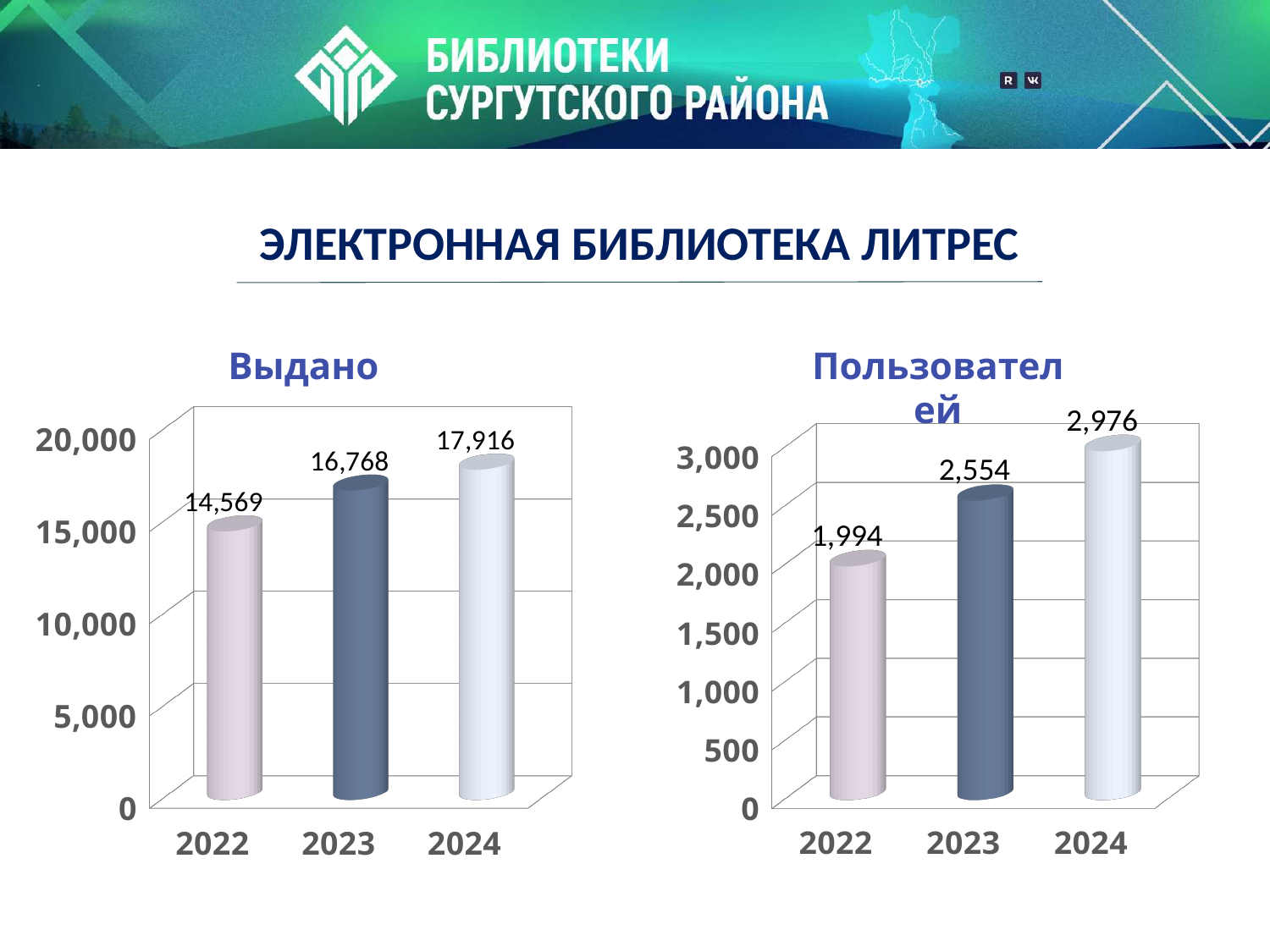
In the 'Пользователей' chart, what is the value for 2022? 1,994 In the 'Выдано' chart, what is the value for 2023? 16,768 In the 'Выдано' chart, is the value for 2022 greater or less than 15,000? less In the 'Выдано' chart, which year has the highest value? 2024 In the 'Выдано' chart, what is the difference between the values for 2024 and 2022? 3,347 What kind of chart is the 'Выдано' chart? bar chart In the 'Пользователей' chart, do the values rise or fall from 2022 to 2024? rise How many years are shown in the 'Пользователей' chart? 3 In the 'Пользователей' chart, what is the difference between the values for 2023 and 2022? 560 In the 'Пользователей' chart, which is larger: the value for 2023 or the value for 2024? 2024 In the 'Пользователей' chart, which year has the lowest value? 2022 What is the title of the chart on the left side of the slide? Выдано